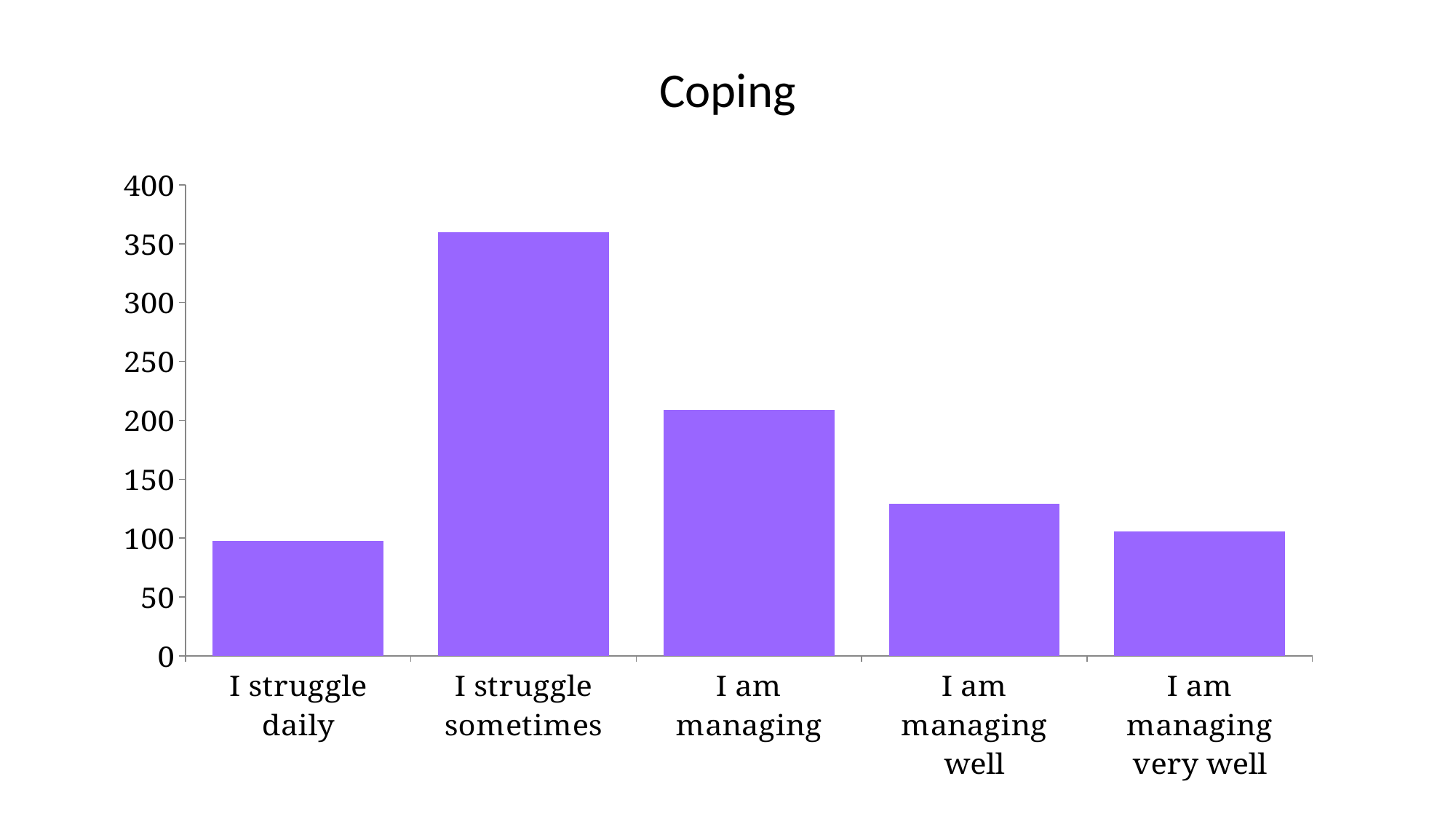
What type of chart is shown on the slide? bar chart Which is larger, the value for "I struggle sometimes" or the value for "I am managing"? I struggle sometimes What is the title of the chart? Coping How many categories are shown on the x axis of the chart? 5 Is the value for "I am managing well" greater or less than 100? greater Which is larger, the value for "I am managing" or the value for "I am managing well"? I am managing Is the value for "I am managing" greater or less than 250? less Is the value for "I am managing very well" greater or less than 150? less Which category has the highest value? I struggle sometimes Do the values rise or fall from "I am managing" to "I am managing very well"? fall